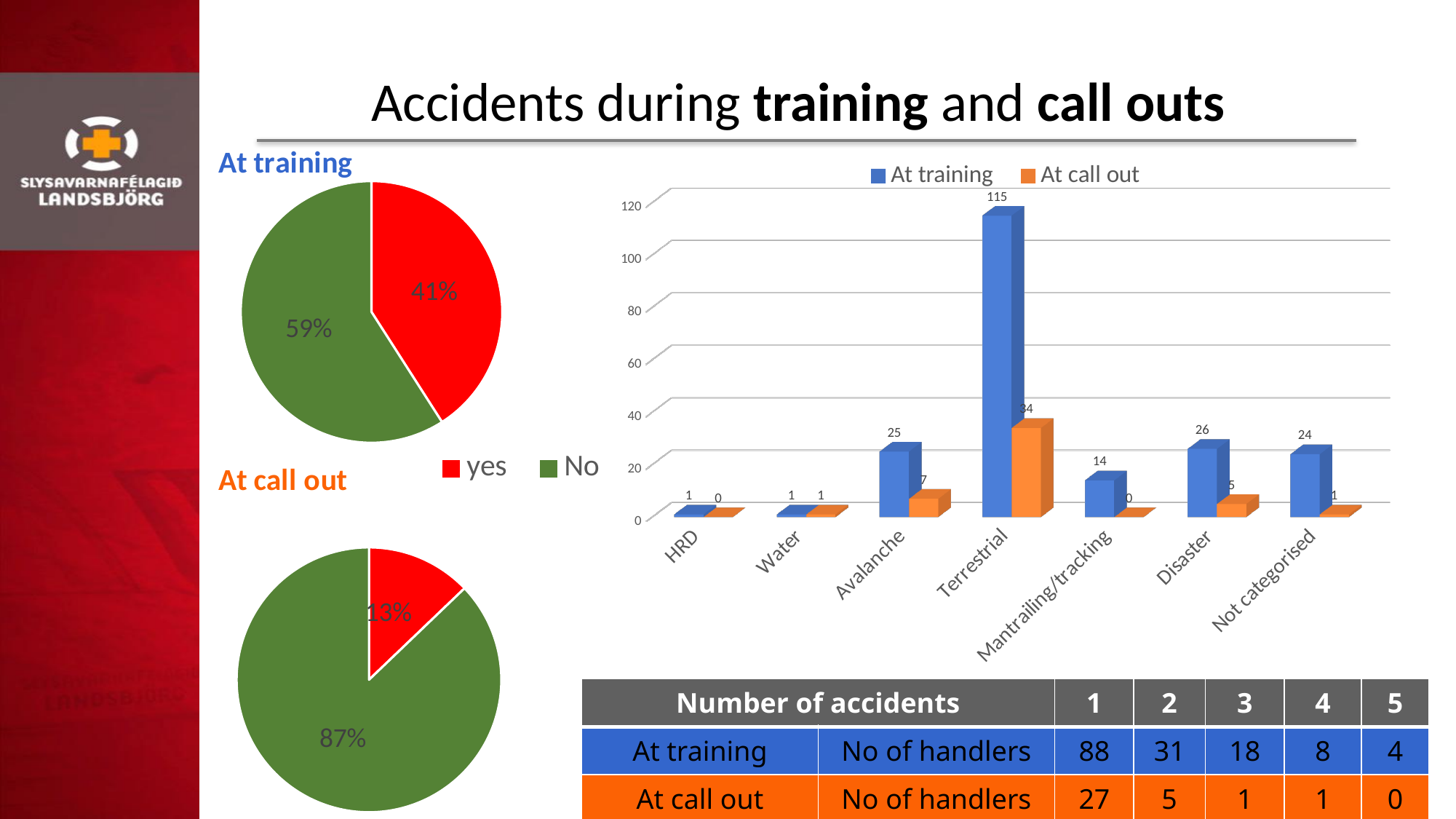
In the bar chart, what is the difference between the 'At training' and 'At call out' values for Terrestrial? 81 In the 'At call out' pie chart, what share is labelled 'No'? 87% In the bar chart, what is the 'At training' value for Mantrailing/tracking? 14 How many series does the legend of the bar chart list? 2 In the bar chart, what is the 'At call out' value for Avalanche? 7 In the bar chart, which has the larger 'At training' value, Disaster or Not categorised? Disaster What are the two legend entries shown for the pie charts? yes, No How many categories are shown on the x axis of the bar chart? 7 In the 'At training' pie chart, what share is labelled 'yes'? 41% What kind of chart is the chart on the right side of the slide? Bar chart In the bar chart, which category has the highest 'At training' value? Terrestrial In the bar chart, what is the 'At training' value for Terrestrial? 115